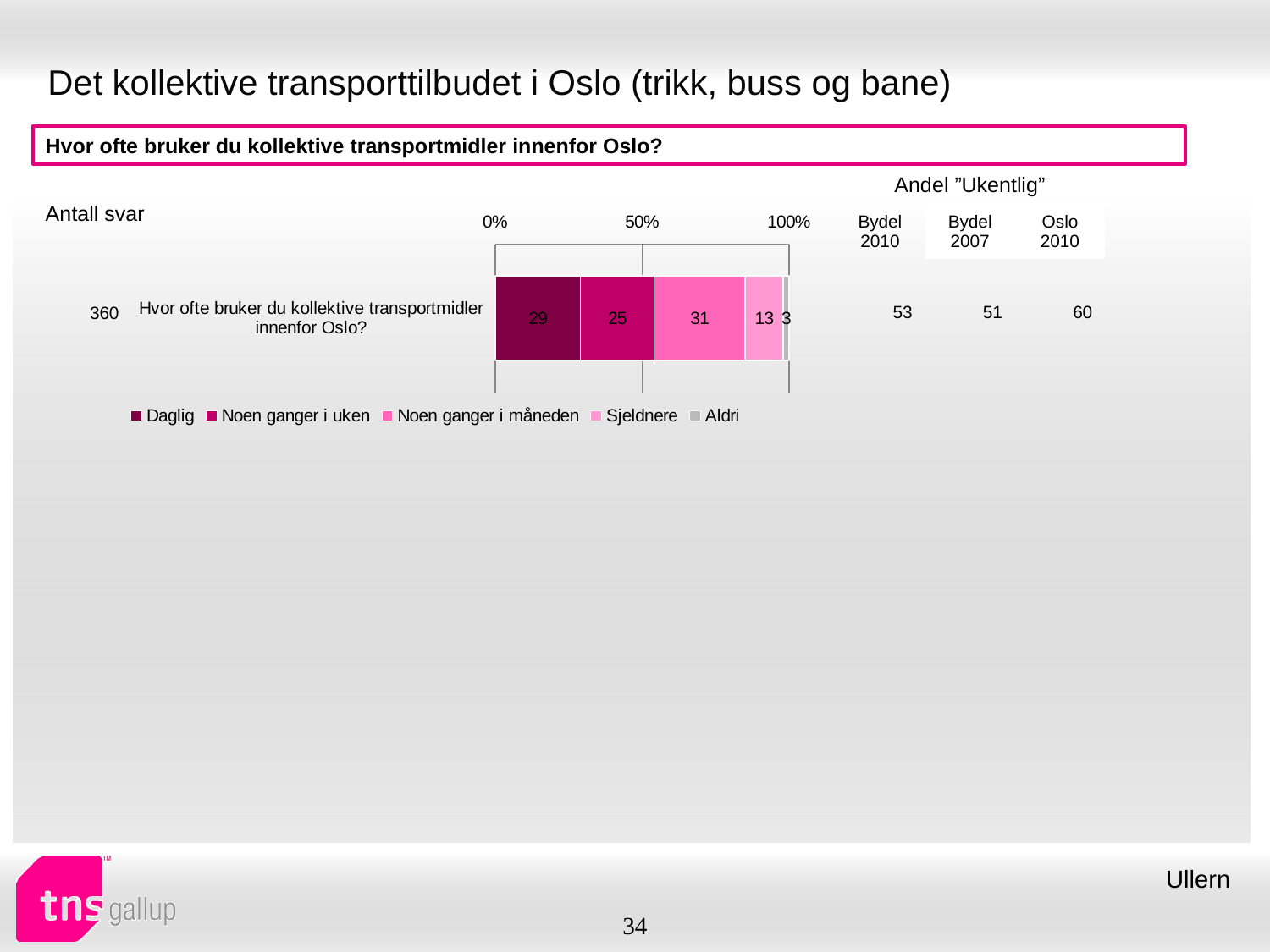
How many series does the chart legend list? 5 What is the value for "Noen ganger i uken" in the bar? 25 Which is larger, the "Daglig" segment or the "Sjeldnere" segment? Daglig What is the value for "Aldri" in the bar? 3 What is the value for "Sjeldnere" in the bar? 13 Which legend category has the smallest segment in the bar? Aldri How many bars (categories) are plotted in the chart? 1 What is the value for "Daglig" in the bar? 29 What kind of chart is shown on the slide? Stacked bar chart What is the value for "Noen ganger i måneden" in the bar? 31 Which legend category has the largest segment in the bar? Noen ganger i måneden What is the difference between the "Daglig" and "Noen ganger i uken" values? 4